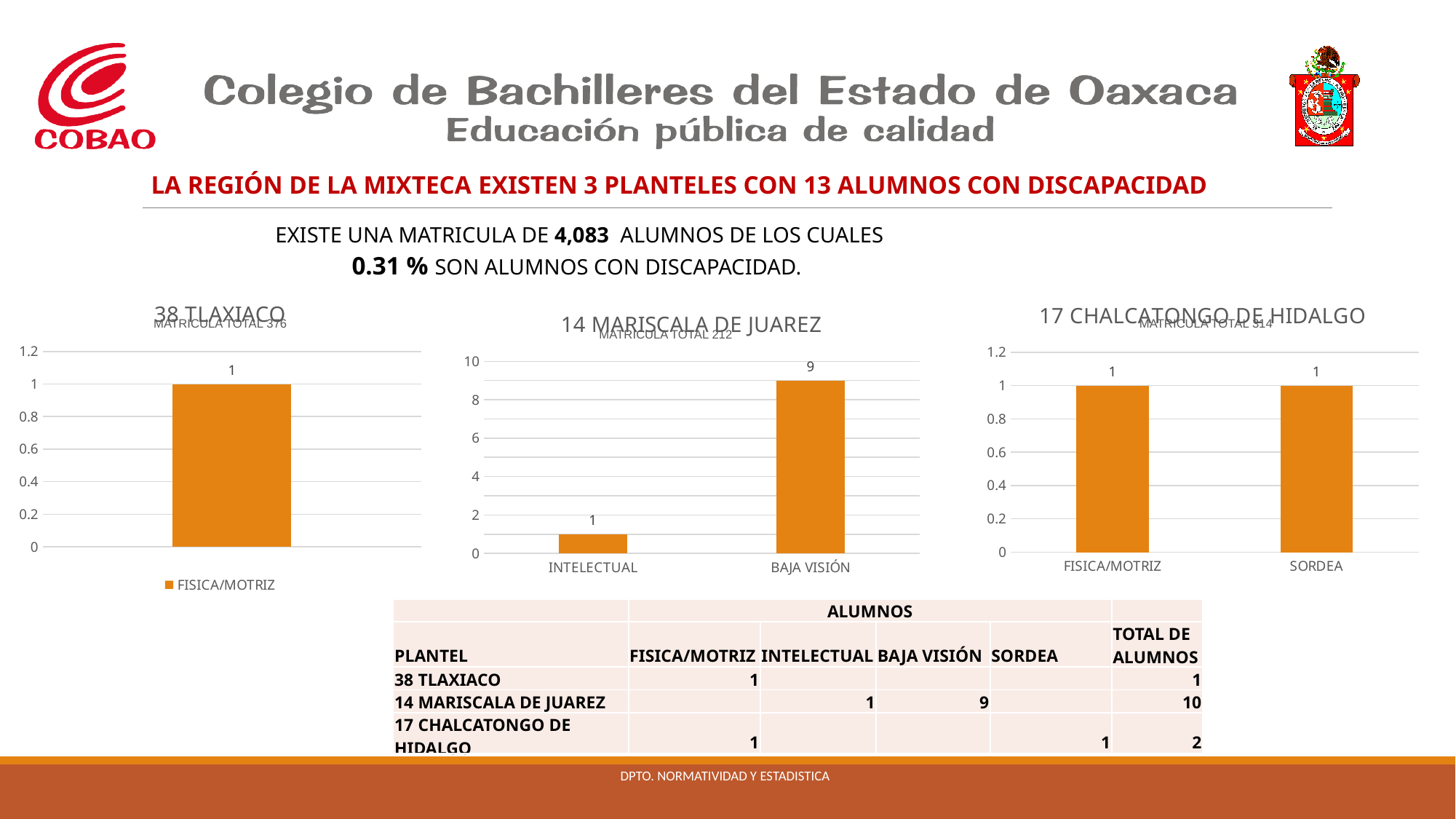
In the '38 TLAXIACO' chart, what series name does the legend show? FISICA/MOTRIZ In the '14 MARISCALA DE JUAREZ' chart, which category has the lowest value? INTELECTUAL In the '14 MARISCALA DE JUAREZ' chart, what is the value for BAJA VISIÓN? 9 In the '38 TLAXIACO' chart, how many series does the legend list? 1 In the '14 MARISCALA DE JUAREZ' chart, what is the difference between BAJA VISIÓN and INTELECTUAL? 8 What type of chart is the '14 MARISCALA DE JUAREZ' chart? Bar chart In the '17 CHALCATONGO DE HIDALGO' chart, how many categories are shown? 2 In the '14 MARISCALA DE JUAREZ' chart, which category has the highest value? BAJA VISIÓN In the '14 MARISCALA DE JUAREZ' chart, what is the value for INTELECTUAL? 1 In the '17 CHALCATONGO DE HIDALGO' chart, what is the value for SORDEA? 1 In the '38 TLAXIACO' chart, what is the value of the FISICA/MOTRIZ bar? 1 In the '14 MARISCALA DE JUAREZ' chart, is the value for BAJA VISIÓN greater or less than 8? greater